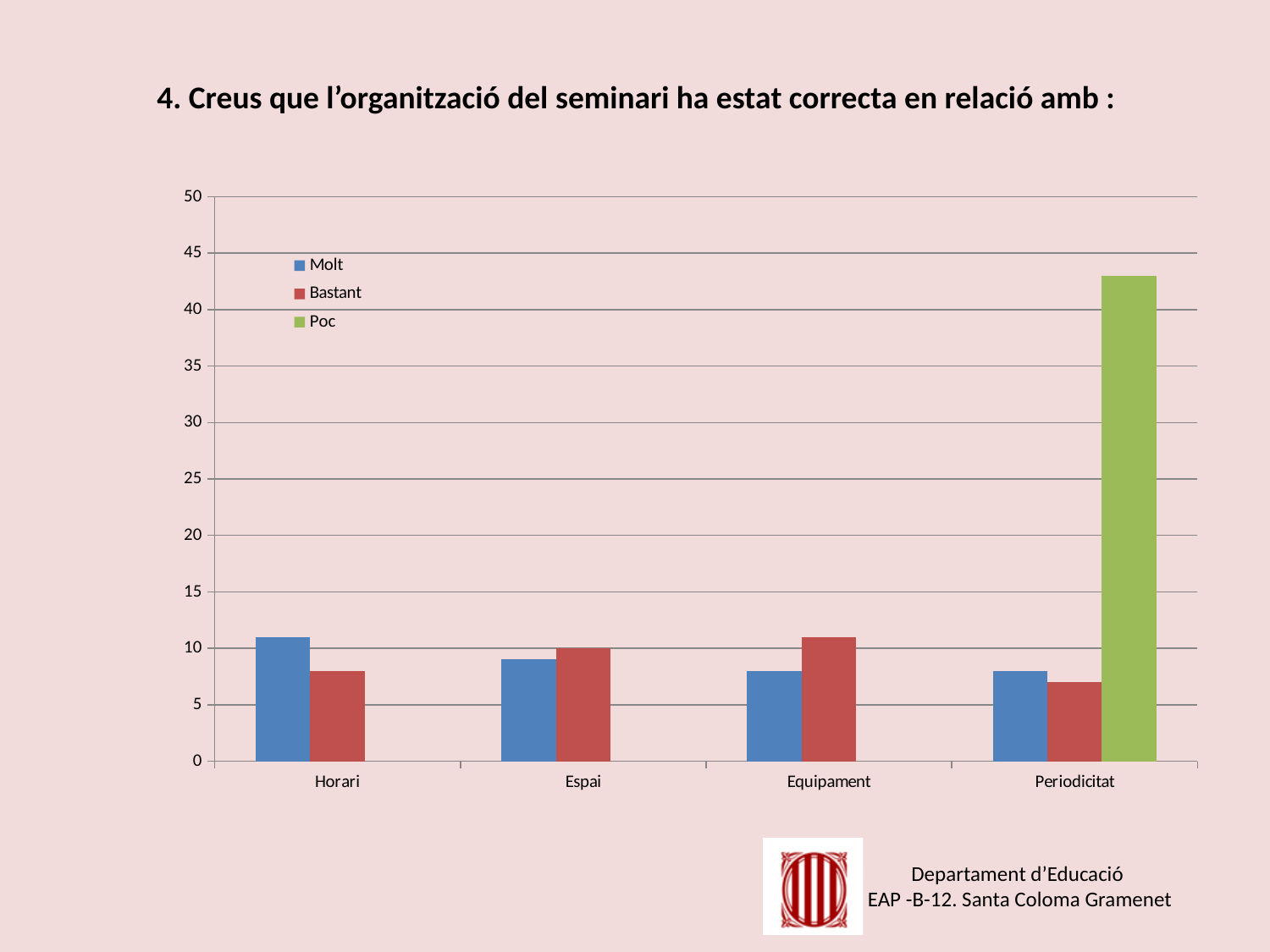
For Horari, which is larger: the Molt value or the Bastant value? Molt How many categories are shown on the x axis of the chart? 4 For Equipament, which is larger: the Molt value or the Bastant value? Bastant What kind of chart is shown on the slide? bar chart How many series does the chart's legend list? 3 Which series has the highest value for Periodicitat? Poc Is the Bastant value for Periodicitat greater or less than 10? less Which category has the tallest bar in the chart? Periodicitat Is the Poc value for Periodicitat greater or less than 40? greater Is the Molt value for Espai greater or less than 10? less Which series names are listed in the chart's legend? Molt, Bastant, Poc